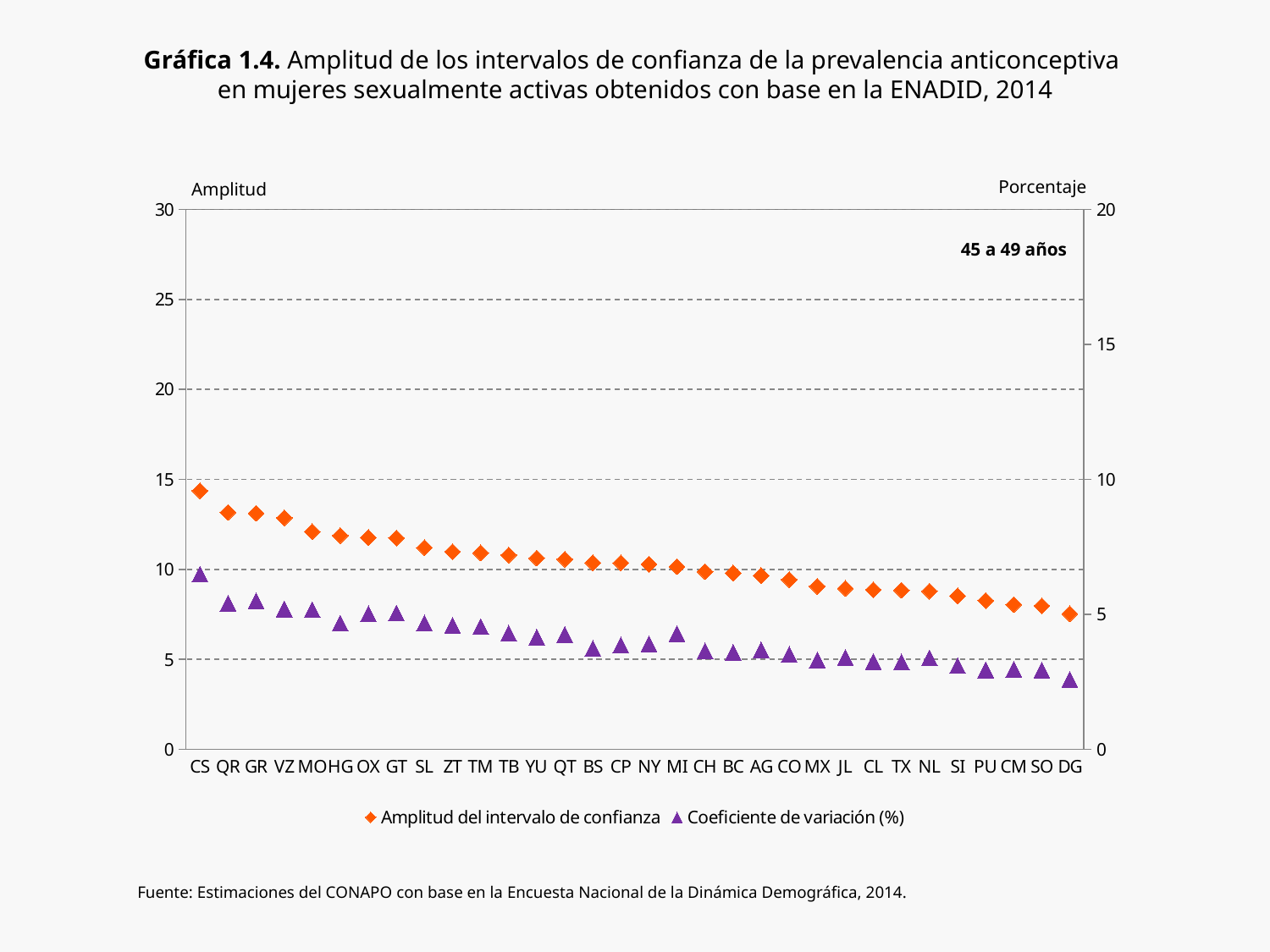
What are the two series named in the legend? Amplitud del intervalo de confianza; Coeficiente de variación (%) Is the Amplitud del intervalo de confianza value for DG greater or less than 10 on the left axis? less Which has a larger Amplitud del intervalo de confianza value, CS or DG? CS Which category has the lowest value for Amplitud del intervalo de confianza? DG Do the values for Amplitud del intervalo de confianza rise or fall from left to right along the x axis? fall Which has a larger Coeficiente de variación (%) value, CS or DG? CS How many series does the legend list? 2 What age group label is shown inside the plot area? 45 a 49 años How many categories (states) are shown along the x axis? 32 What kind of chart is shown on the slide? scatter chart Which category has the highest value for Amplitud del intervalo de confianza? CS Is the Amplitud del intervalo de confianza value for CS greater or less than 10 on the left axis? greater